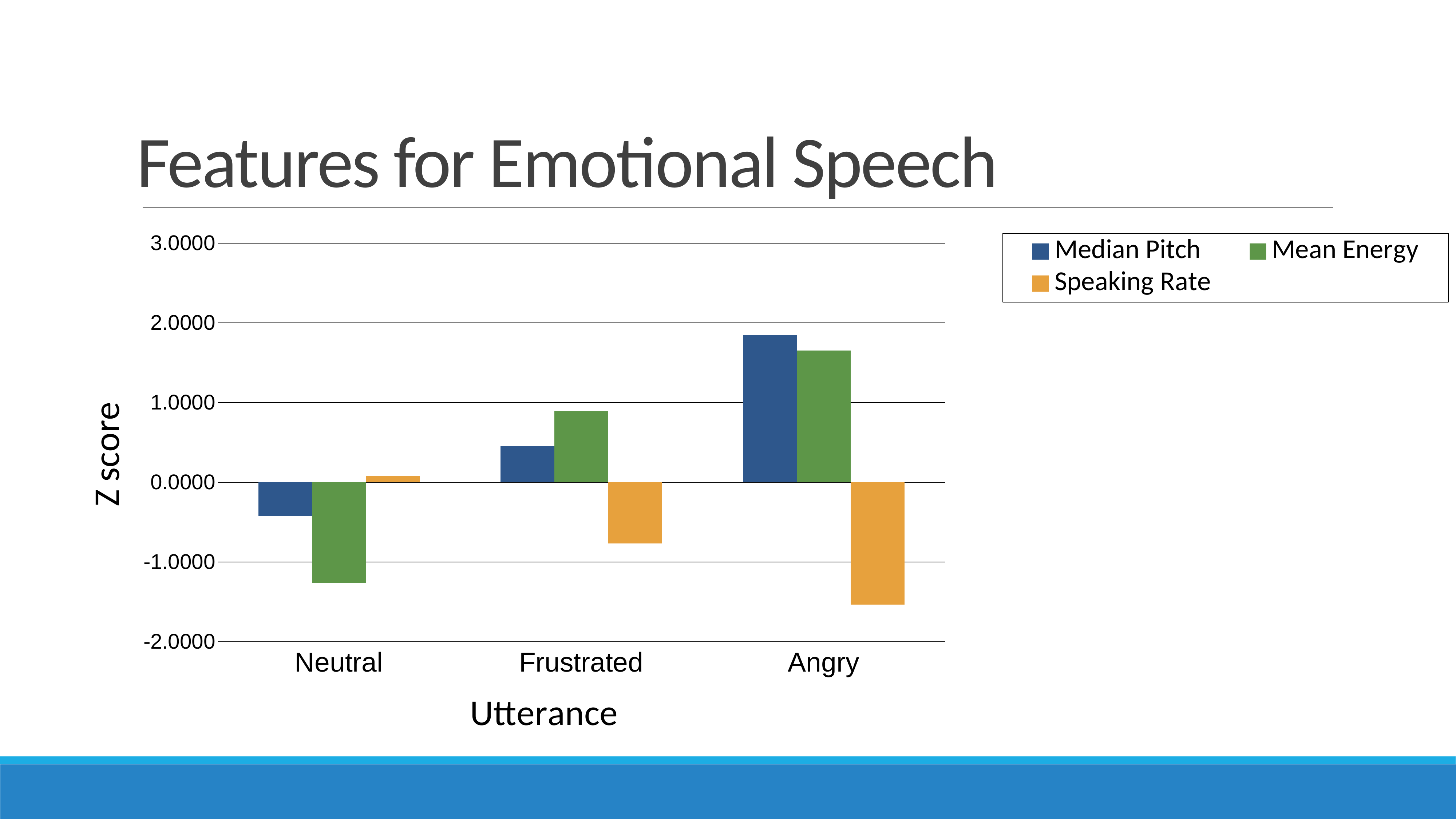
Does the Median Pitch z score rise or fall from Neutral to Angry? rise Is the Mean Energy value for Neutral greater or less than -1.0000? less Does the Speaking Rate z score rise or fall from Neutral to Angry? fall Which utterance has the lowest Mean Energy z score? Neutral What kind of chart is shown on the slide? bar chart Is the Median Pitch value for Angry greater or less than 1.0000? greater How many series does the legend list? 3 Which utterance has the highest Median Pitch z score? Angry How many utterance categories are shown on the x axis? 3 What is the title of the vertical axis? Z score For the Frustrated utterance, which is larger: Median Pitch or Mean Energy? Mean Energy Which utterance has the lowest Speaking Rate z score? Angry